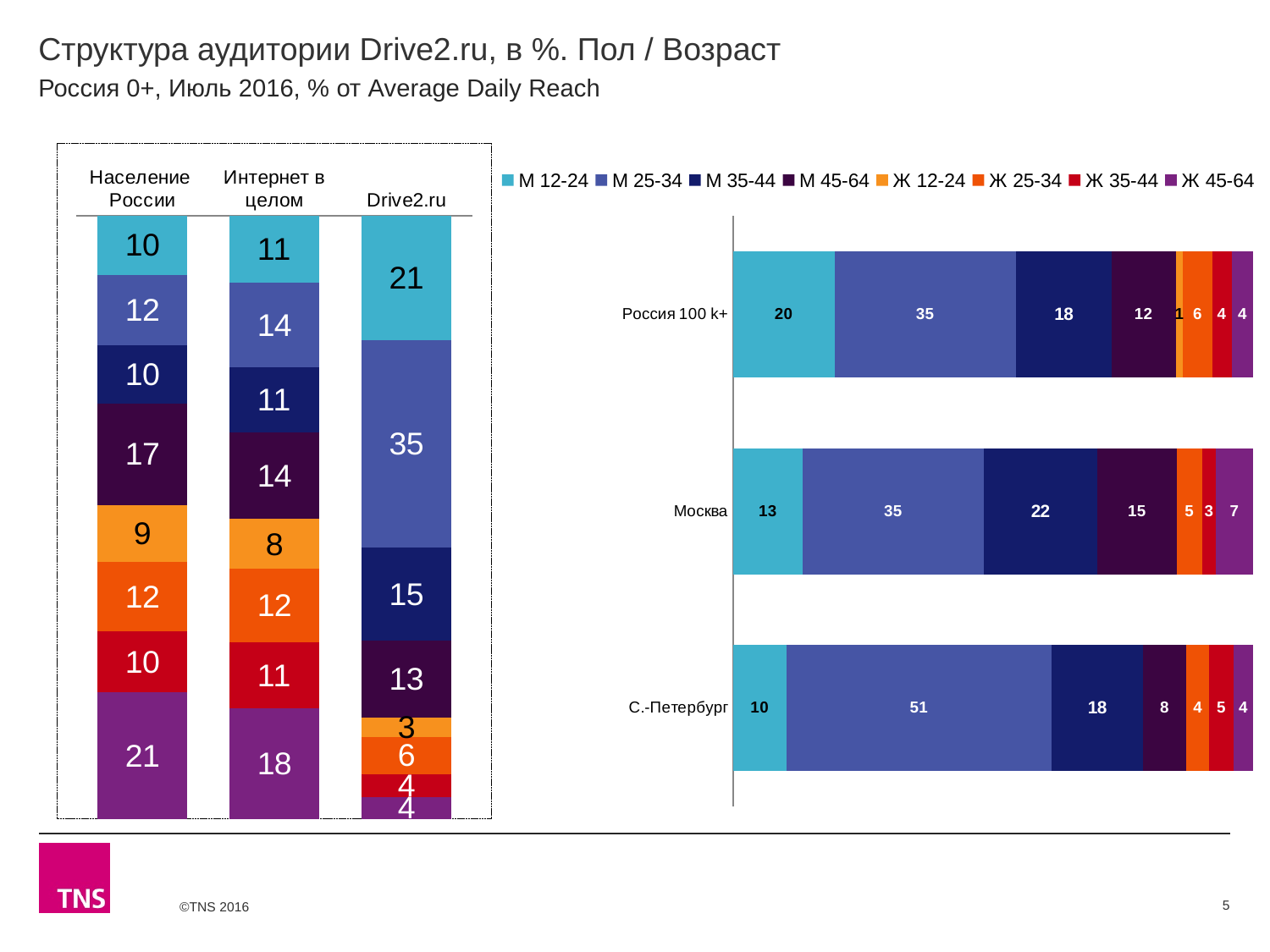
In the right chart, which city or region has the smallest М 12-24 segment? С.-Петербург What kind of chart is the right chart? Stacked bar chart In the left chart, what is the value of the Ж 45-64 segment for Население России? 21 In the right chart, what is the value of the М 25-34 segment for С.-Петербург? 51 In the left chart, what is the difference between the М 12-24 values for Drive2.ru and Интернет в целом? 10 In the right chart, what is the value of the М 35-44 segment for Москва? 22 In the left chart, what is the value of the М 25-34 segment for Drive2.ru? 35 How many categories are shown in the right chart? 3 In the right chart, what is the value of the М 12-24 segment for Россия 100 k+? 20 In the right chart, which city or region has the largest М 25-34 segment? С.-Петербург In the right chart, which is larger: the М 45-64 segment for Москва or for С.-Петербург? Москва How many series does the legend list? 8